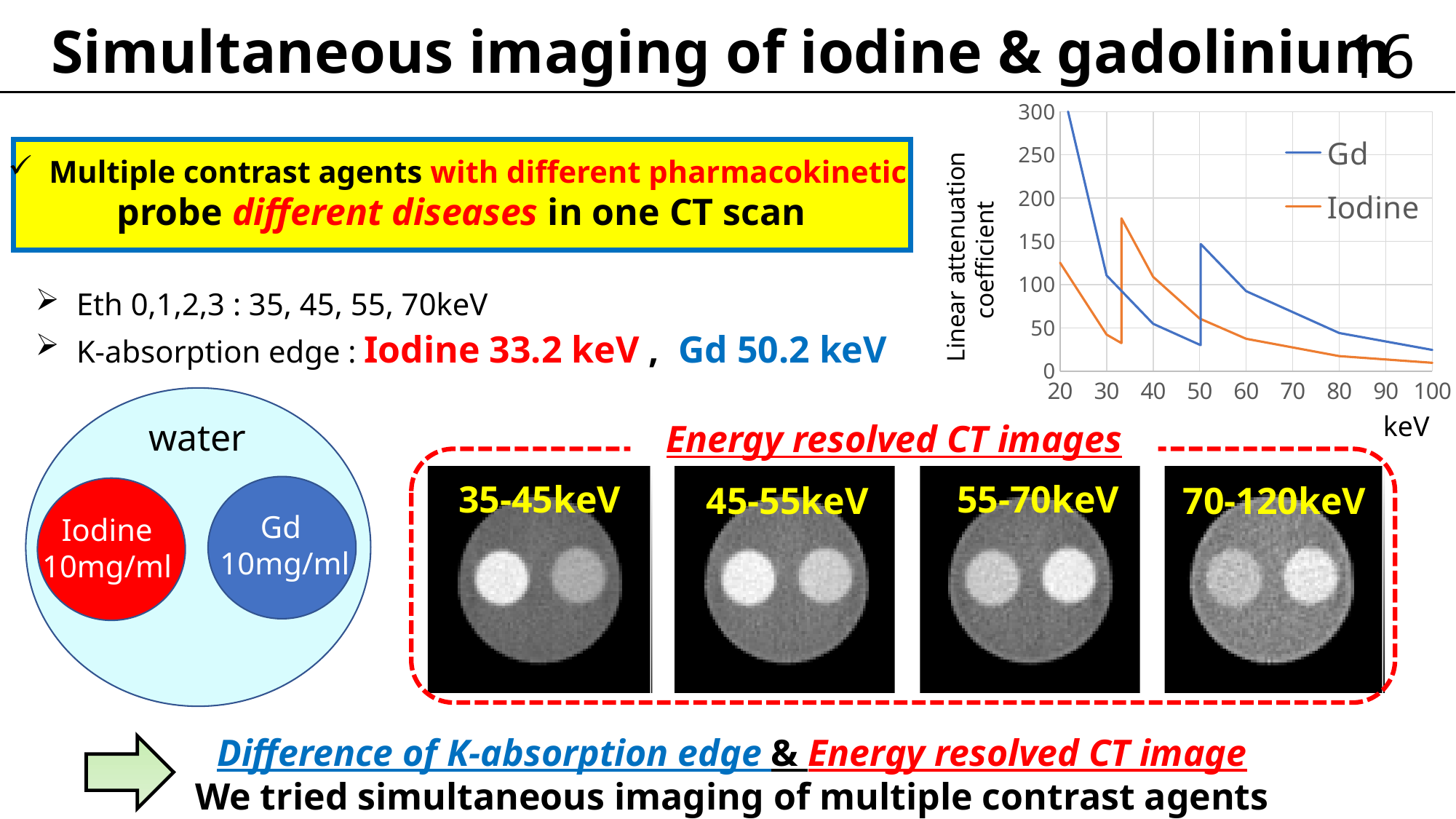
In the line chart, is the value for Gd at 100 keV greater or less than 50? less What kind of chart is shown in the top right of the slide? line chart In the line chart, does the Gd value rise or fall as keV increases from 60 to 100? fall In the line chart, is the value for Gd at 20 keV greater or less than 250? greater In the line chart, which series reaches the highest value anywhere on the chart? Gd What is the label of the y axis of the line chart? Linear attenuation coefficient How many series does the legend of the line chart list? 2 In the line chart, is the value for Iodine at 20 keV greater or less than 100? greater In the line chart, which series has the larger value at 40 keV, Gd or Iodine? Iodine In the line chart, which series has the larger value at 60 keV, Gd or Iodine? Gd What are the two series named in the legend of the line chart? Gd and Iodine